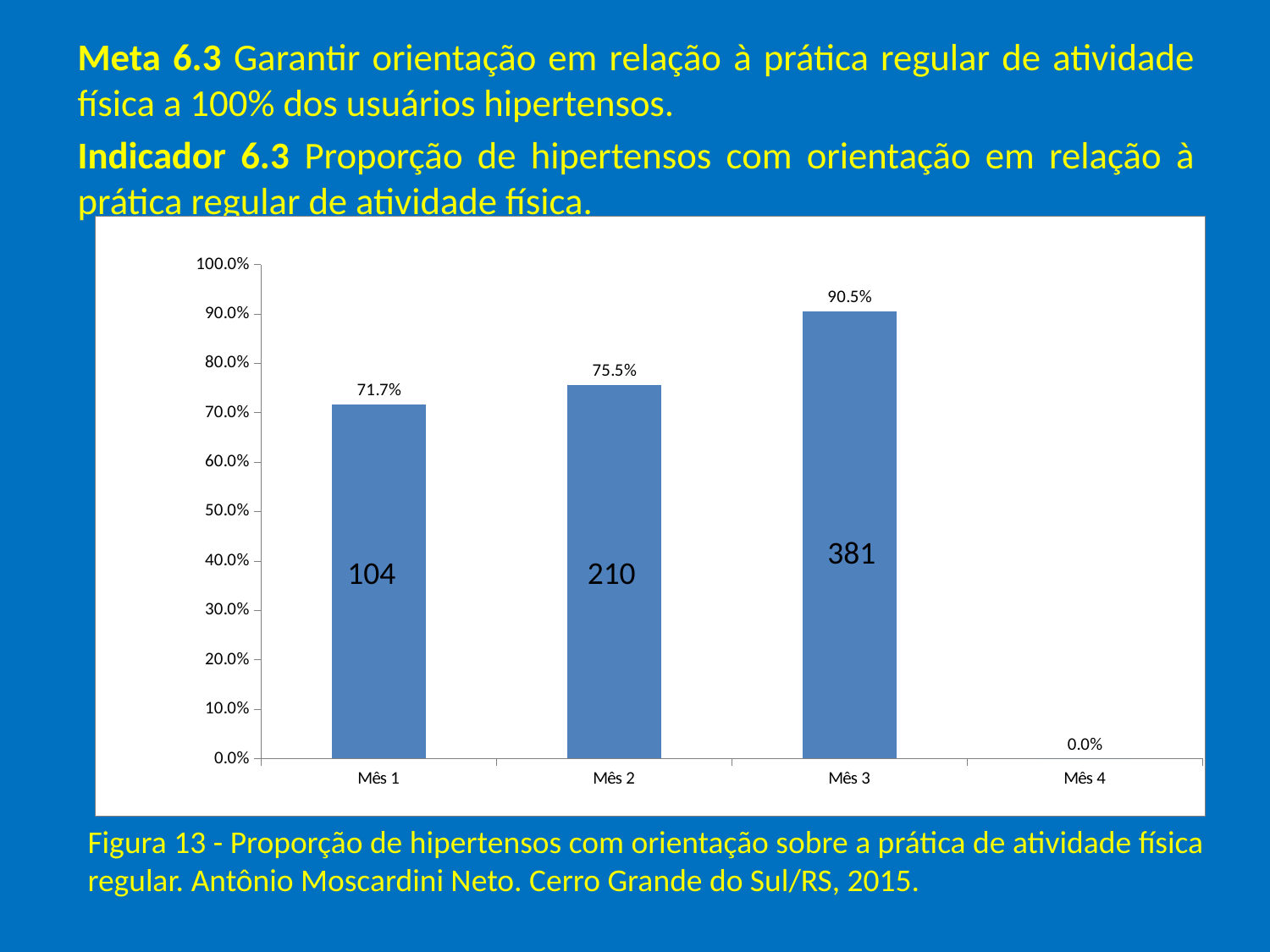
What number is printed inside the bar for Mês 2? 210 What is the difference between the values for Mês 3 and Mês 2? 15.0% What is the value for Mês 4? 0.0% What is the value for Mês 1? 71.7% What is the difference between the values for Mês 2 and Mês 1? 3.8% Do the values rise or fall from Mês 1 to Mês 3? Rise Which is larger, the value for Mês 1 or the value for Mês 2? Mês 2 What is the value for Mês 3? 90.5% Which month has the highest proportion? Mês 3 How many months are shown on the x axis? 4 What kind of chart is this? Bar chart Which month has the lowest proportion? Mês 4